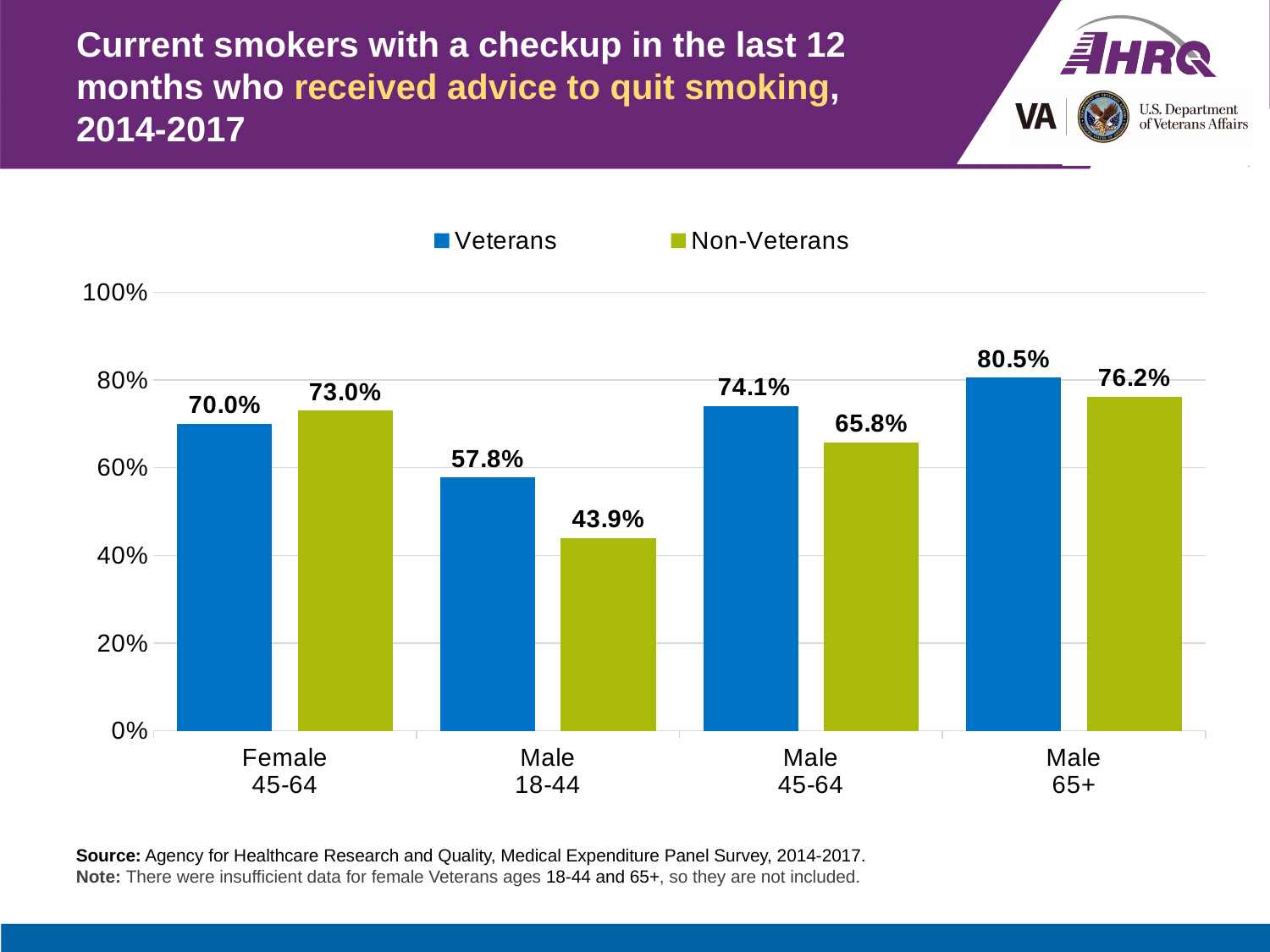
How many categories are shown on the x axis? 4 Which category has the highest value for Veterans? Male 65+ What is the difference between Veterans and Non-Veterans in the Male 65+ category? 4.3% What is the value for Non-Veterans in the Female 45-64 category? 73.0% Is the value for Veterans in the Male 18-44 category greater or less than 60%? less What is the value for Non-Veterans in the Male 18-44 category? 43.9% What is the value for Veterans in the Male 45-64 category? 74.1% Which category has the lowest value for Non-Veterans? Male 18-44 How many series does the legend list? 2 Which is larger in the Female 45-64 category, Veterans or Non-Veterans? Non-Veterans What kind of chart is shown on the slide? Bar chart What is the difference between Veterans and Non-Veterans in the Male 18-44 category? 13.9%